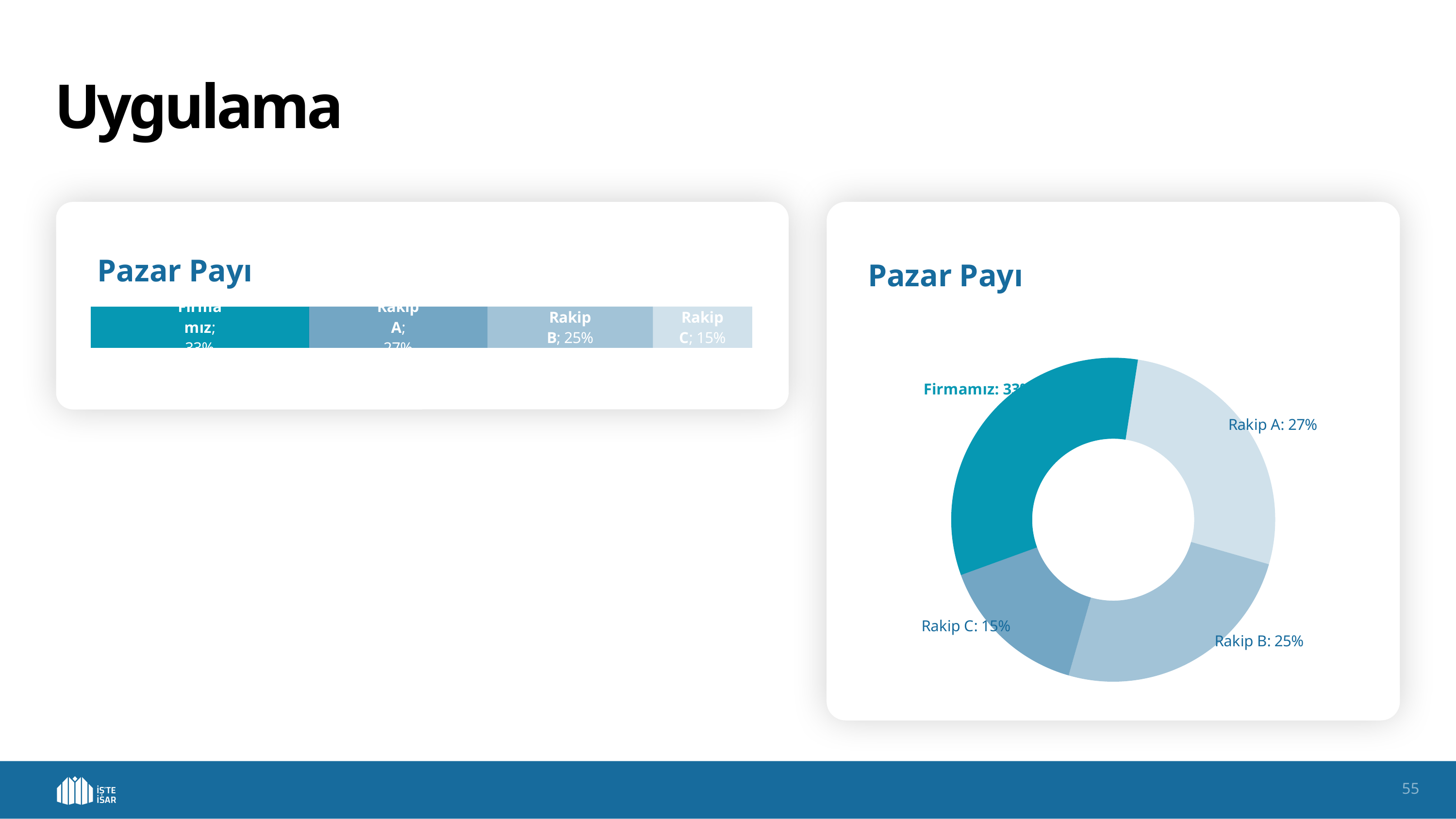
In the donut chart on the right, what is the value for Rakip A? 27% In the stacked bar chart on the left, what is the value for Rakip B? 25% What kind of chart is shown on the left side of the slide? Stacked bar chart In the donut chart on the right, what is the value for Rakip C? 15% In the donut chart on the right, what is the difference between Rakip A and Rakip C? 12% In the stacked bar chart on the left, what is the value for Rakip C? 15% In the donut chart on the right, what is the value for Rakip B? 25% In the donut chart on the right, which category has the smallest share? Rakip C What is the title of the chart on the right? Pazar Payı In the donut chart on the right, which is larger, Rakip A or Rakip B? Rakip A In the donut chart on the right, which category has the largest share? Firmamız In the donut chart on the right, how many categories are shown? 4